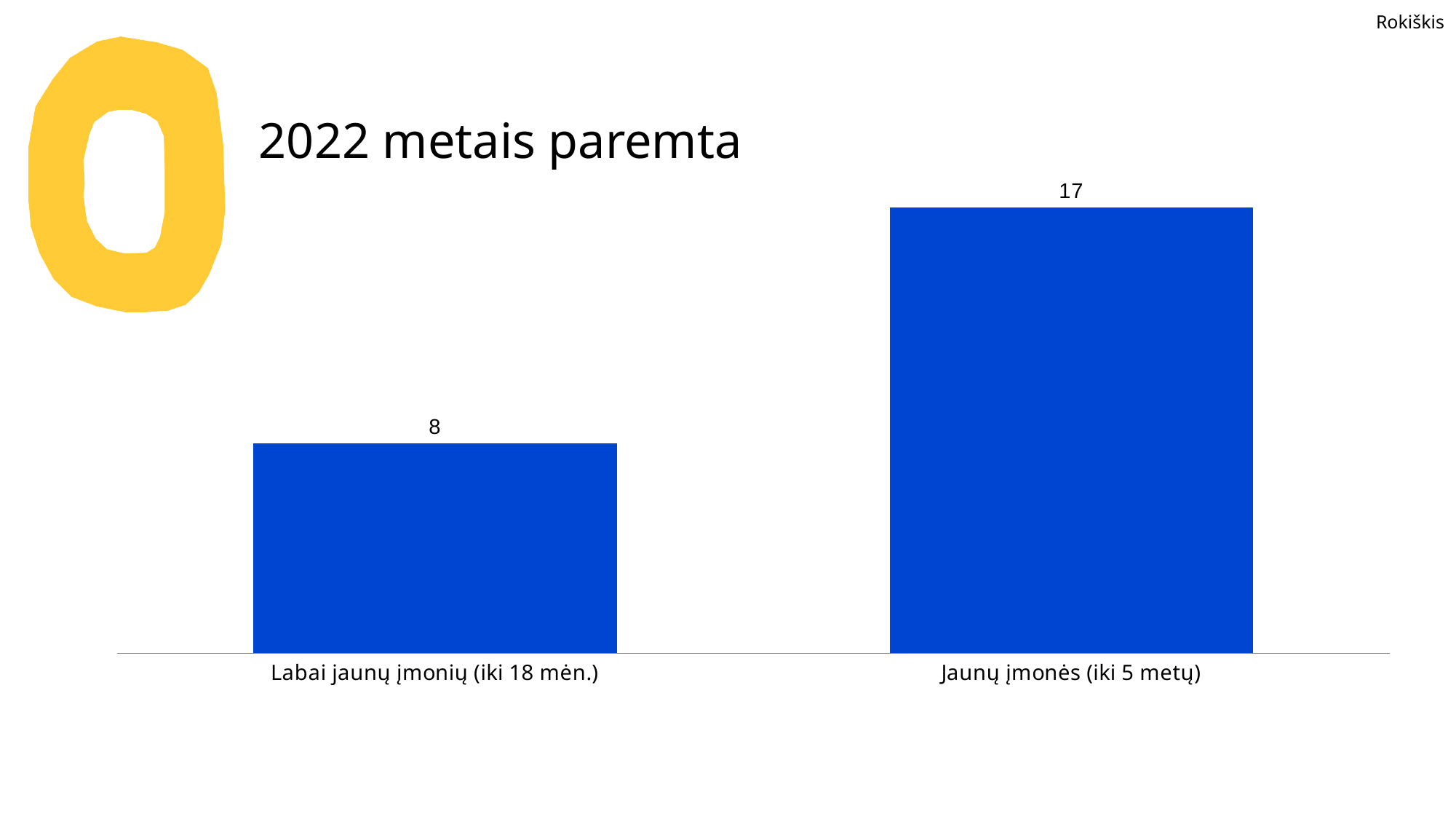
What is the title of the chart? 2022 metais paremta What colour are the bars in the chart? Blue What is the total of the two values shown in the chart? 25 Which category has the highest value? Jaunų įmonės (iki 5 metų) What is the difference between the values for "Jaunų įmonės (iki 5 metų)" and "Labai jaunų įmonių (iki 18 mėn.)"? 9 What is the value for "Labai jaunų įmonių (iki 18 mėn.)"? 8 Which is larger: the value for "Labai jaunų įmonių (iki 18 mėn.)" or for "Jaunų įmonės (iki 5 metų)"? Jaunų įmonės (iki 5 metų) What kind of chart is shown on the slide? Bar chart How many categories are shown in the chart? 2 Which category has the lowest value? Labai jaunų įmonių (iki 18 mėn.) What is the value for "Jaunų įmonės (iki 5 metų)"? 17